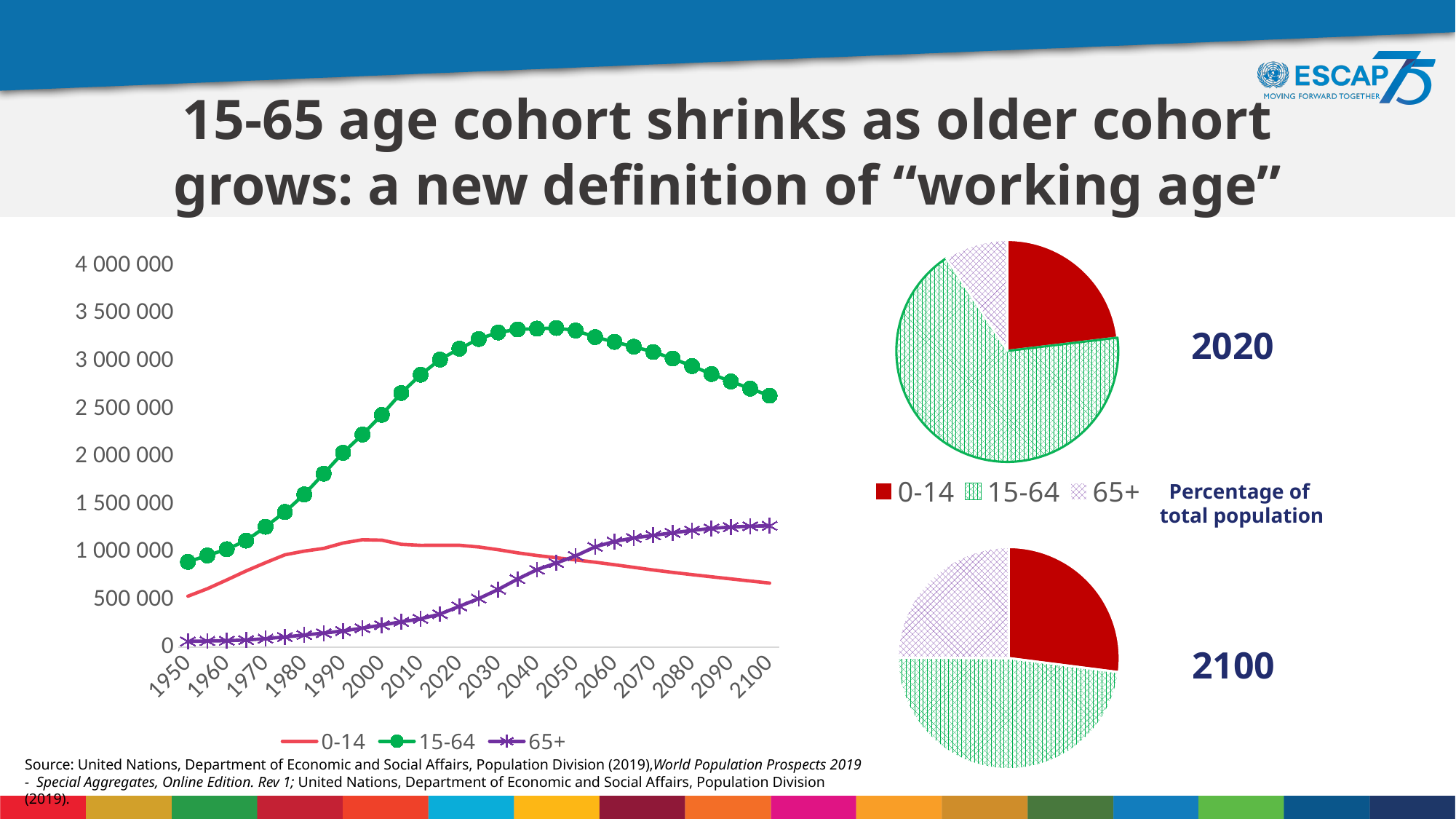
In the left line chart, does the 15-64 series rise or fall from 2040 to 2100? falls Which two years do the pie charts on the right represent? 2020 and 2100 In the left line chart, is the value for 15-64 in 2040 greater or less than 3 000 000? greater How many series does the legend of the left line chart list? 3 In the left line chart, does the 65+ series rise or fall from 1950 to 2100? rises In the left line chart, is the value for 0-14 in 2000 greater or less than 1 000 000? greater In the 2020 pie chart, which age group has the largest slice? 15-64 In the left line chart, is the value for 65+ in 1950 greater or less than 500 000? less In the left line chart, which series has the highest value in 2040? 15-64 What kind of chart is the chart on the left of the slide? line chart In the left line chart, which is larger in 2100: the value for 65+ or the value for 0-14? 65+ How many year labels are shown on the x axis of the left line chart? 16